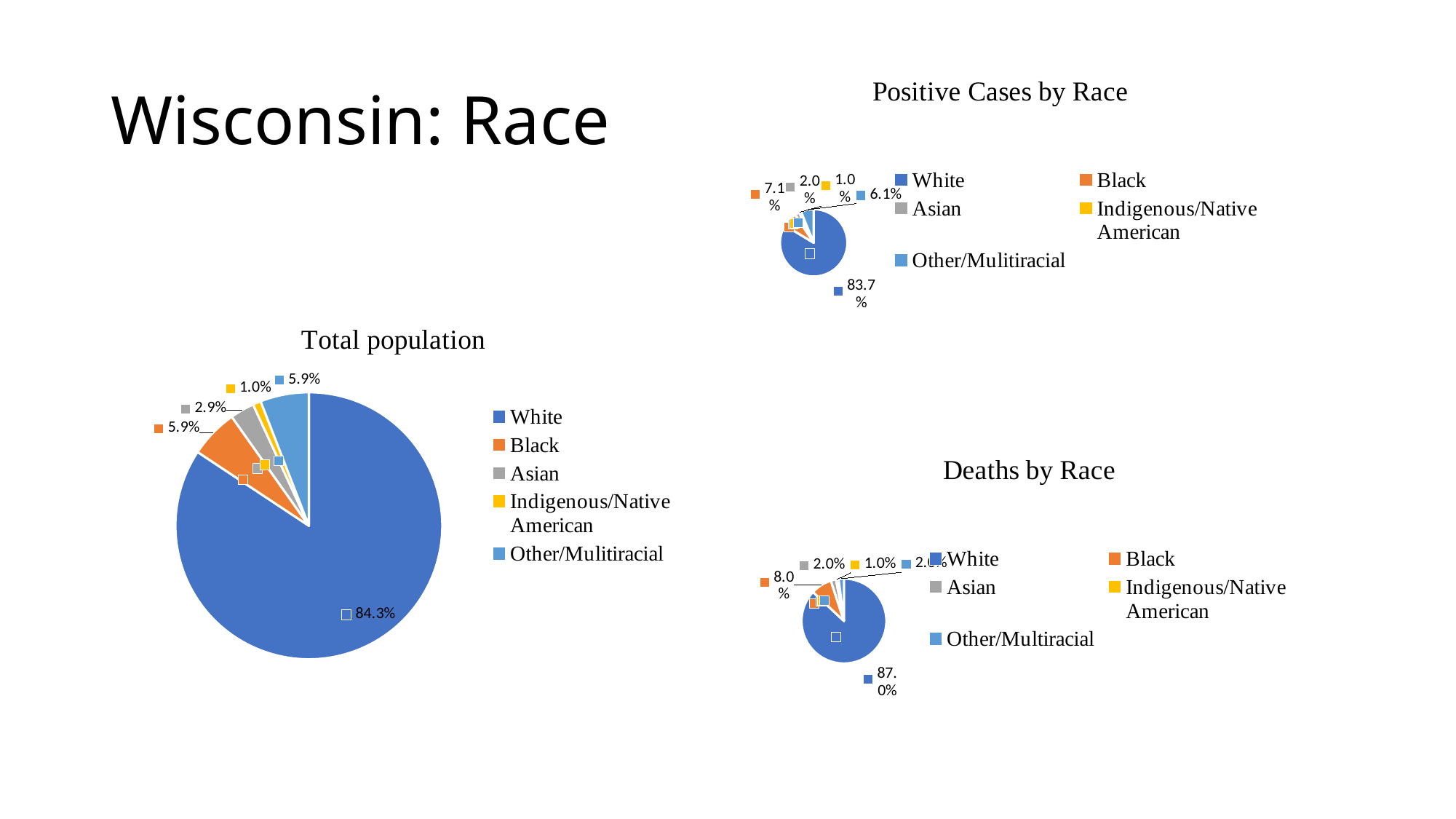
How many categories does the legend of the Total population chart list? 5 In the Deaths by Race chart, what percentage is shown for White? 87.0% What type of chart is the Positive Cases by Race chart? Pie chart In the Total population chart, what percentage is shown for Asian? 2.9% In the Positive Cases by Race chart, what percentage is shown for Other/Mulitiracial? 6.1% In the Total population chart, what share of the pie is White? 84.3% In the Positive Cases by Race chart, what is the difference between the Black and Asian percentages? 5.1% In the Deaths by Race chart, what percentage is shown for Black? 8.0% In the Deaths by Race chart, which category has the largest slice? White In the Positive Cases by Race chart, what percentage is shown for Black? 7.1% Is the Black share larger in the Total population chart or in the Deaths by Race chart? Deaths by Race In the Total population chart, which category has the smallest slice? Indigenous/Native American